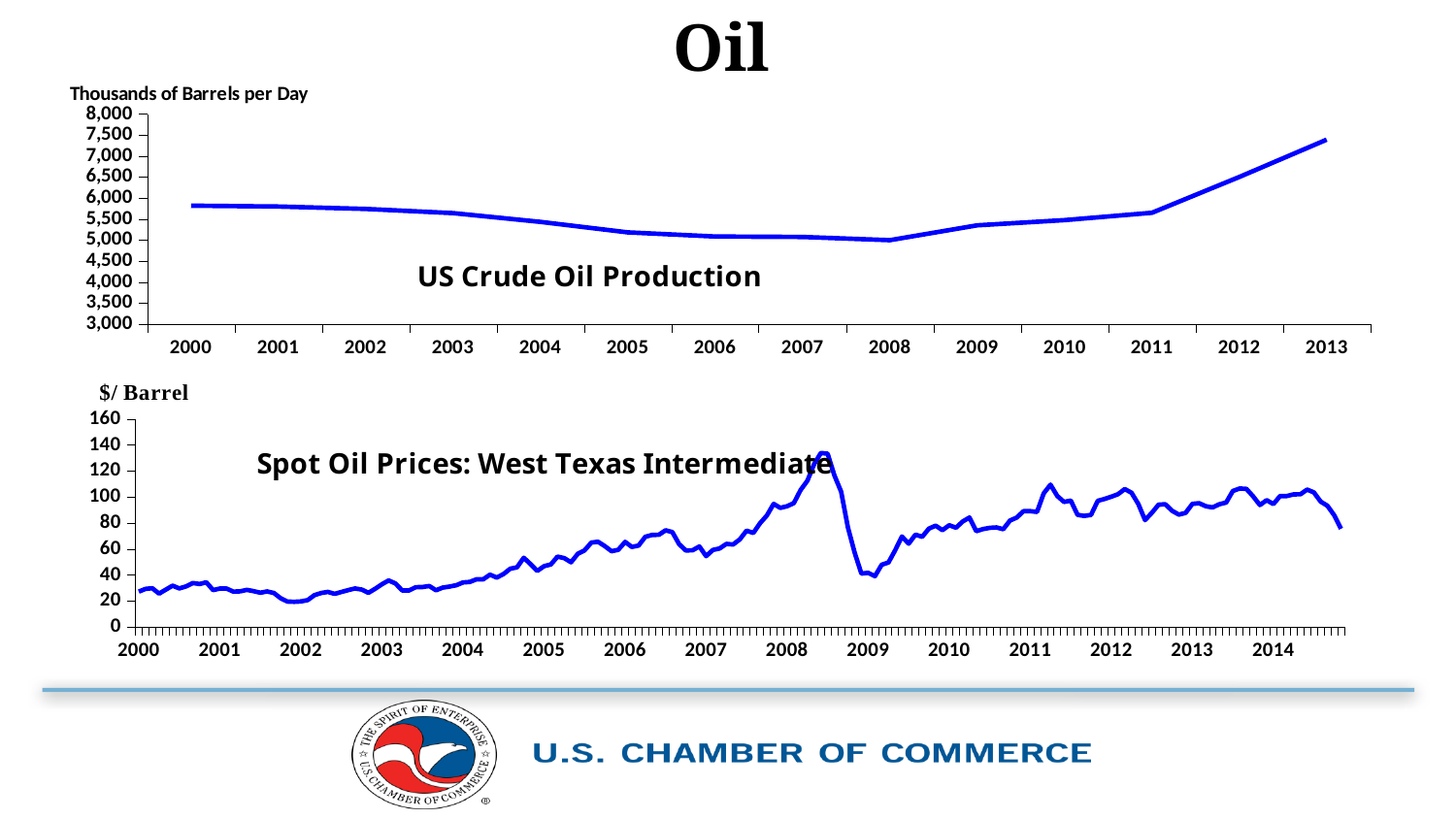
In the US Crude Oil Production chart, which year has the highest production? 2013 In the US Crude Oil Production chart, which is larger, the value for 2000 or the value for 2008? 2000 How many years are labelled on the x axis of the US Crude Oil Production chart? 14 In the US Crude Oil Production chart, is the value for 2008 greater or less than 5,500? less In the US Crude Oil Production chart, which year has the lowest production? 2008 In the US Crude Oil Production chart, is the value for 2013 greater or less than 7,000? greater In the Spot Oil Prices: West Texas Intermediate chart, is the peak price reached in 2008 greater or less than 120? greater In the Spot Oil Prices: West Texas Intermediate chart, does the price generally rise or fall from 2000 to 2014? rise What kind of chart is the US Crude Oil Production chart at the top of the slide? line chart What is the y-axis label of the Spot Oil Prices: West Texas Intermediate chart? $/ Barrel What kind of chart is the Spot Oil Prices: West Texas Intermediate chart at the bottom of the slide? line chart